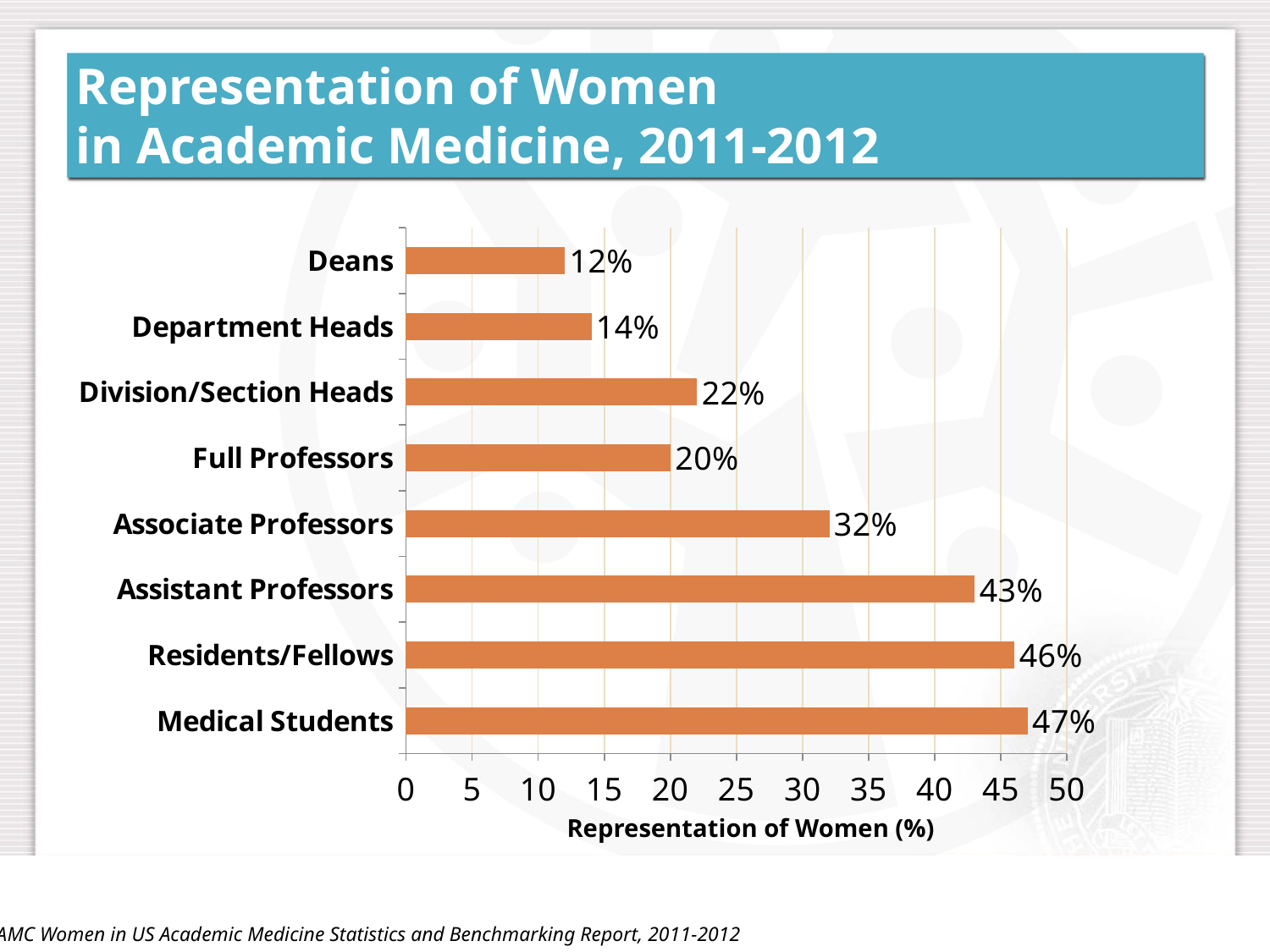
What is the difference in percentage points between Assistant Professors and Full Professors? 23 What is the label of the horizontal axis? Representation of Women (%) Which has a higher representation of women, Division/Section Heads or Full Professors? Division/Section Heads What is the title of the chart? Representation of Women in Academic Medicine, 2011-2012 What is the representation of women among Associate Professors? 32% Which category has the highest representation of women? Medical Students Which category has the lowest representation of women? Deans How many categories are shown in the chart? 8 What kind of chart is shown on the slide? Bar chart What is the representation of women among Residents/Fellows? 46% Is the value for Department Heads greater or less than 15? less What is the representation of women among Deans? 12%